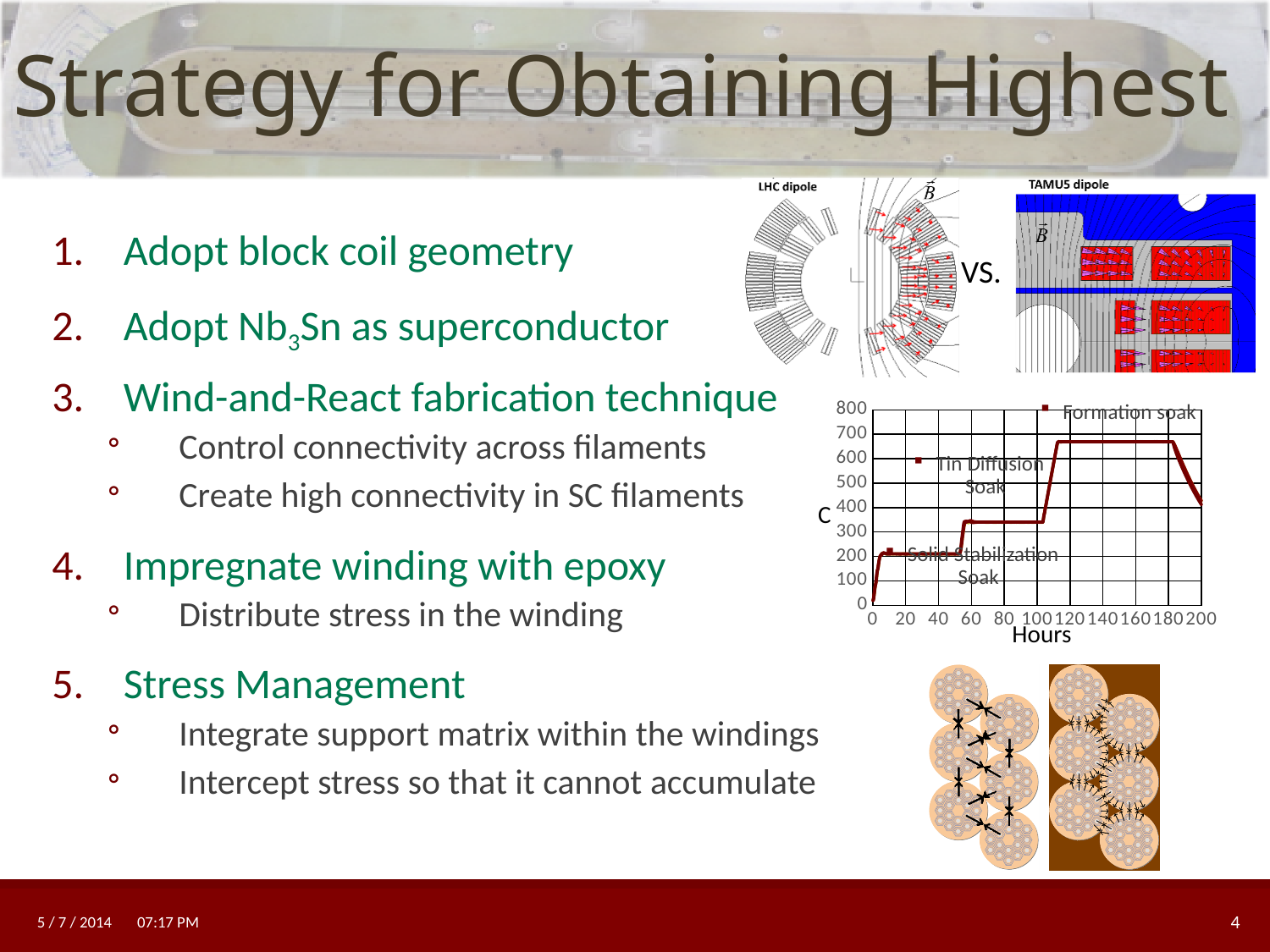
Which plateau is at a higher temperature, the Tin Diffusion Soak or the Solid Stabilization Soak? Tin Diffusion Soak Does the temperature rise or fall between 0 and 120 hours on the chart? rise Which soak stage has the lowest temperature plateau on the chart? Solid Stabilization Soak Which soak stage reaches the highest temperature on the chart? Formation soak Is the temperature of the Tin Diffusion Soak plateau greater or less than 300? greater Is the temperature of the Formation soak plateau greater or less than 700? less Is the temperature of the Formation soak plateau greater or less than 600? greater What is the label on the y axis of the chart? C How many entries does the chart's legend list? 3 What kind of chart is shown on the slide? line chart What is the label on the x axis of the chart? Hours